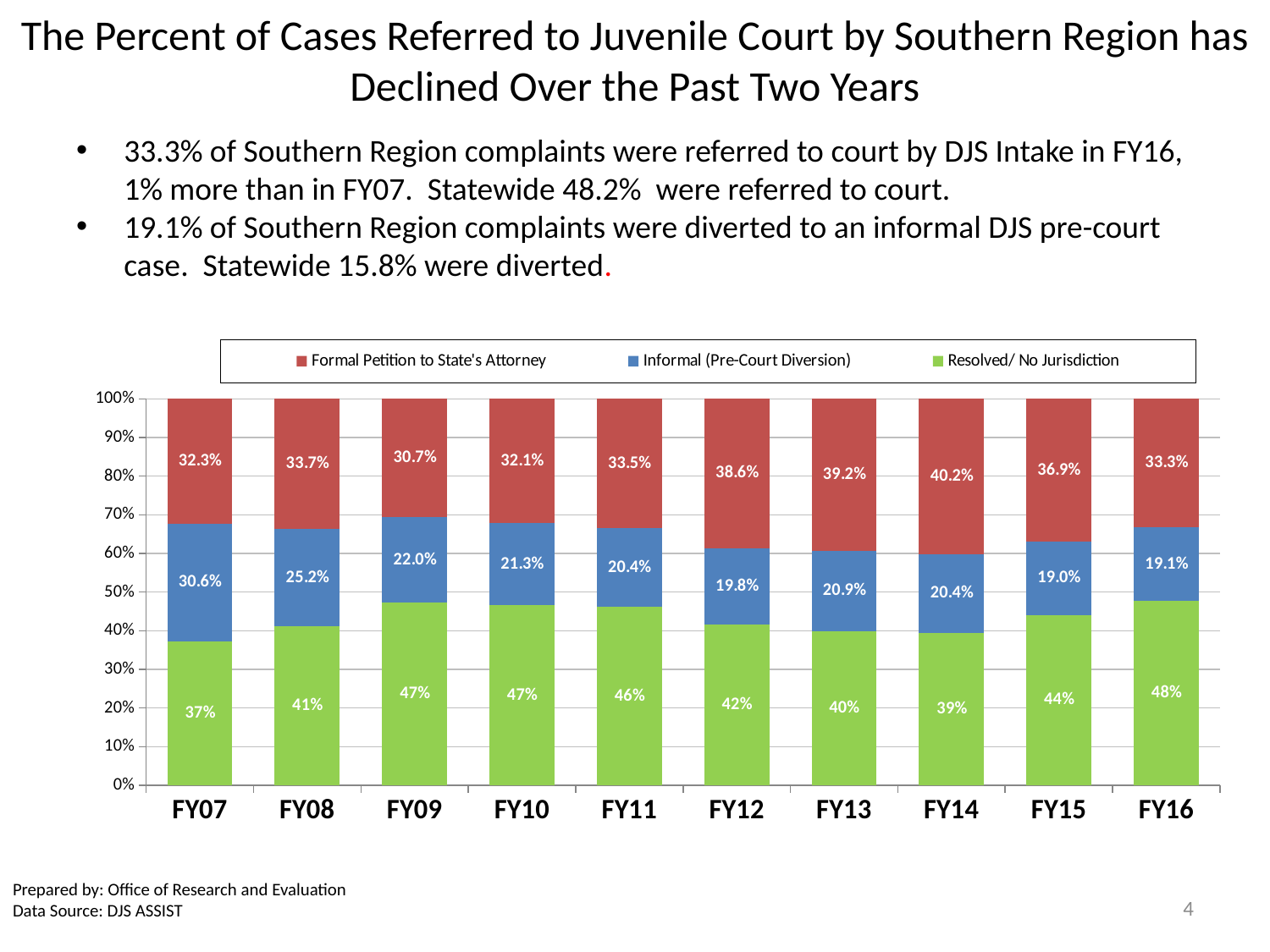
How many fiscal years are shown on the x axis? 10 Which fiscal year has the lowest Resolved/ No Jurisdiction value? FY07 What kind of chart is shown on the slide? Stacked bar chart What is the Resolved/ No Jurisdiction value for FY16? 48% Which is larger, the Informal (Pre-Court Diversion) value for FY08 or for FY09? FY08 Which series is shown in green? Resolved/ No Jurisdiction How many series does the legend list? 3 What is the Informal (Pre-Court Diversion) value for FY07? 30.6% What is the difference between the Formal Petition to State's Attorney values for FY14 and FY16? 6.9% Which fiscal year has the highest Formal Petition to State's Attorney value? FY14 What is the Formal Petition to State's Attorney value for FY14? 40.2% Which fiscal year has the lowest Informal (Pre-Court Diversion) value? FY15